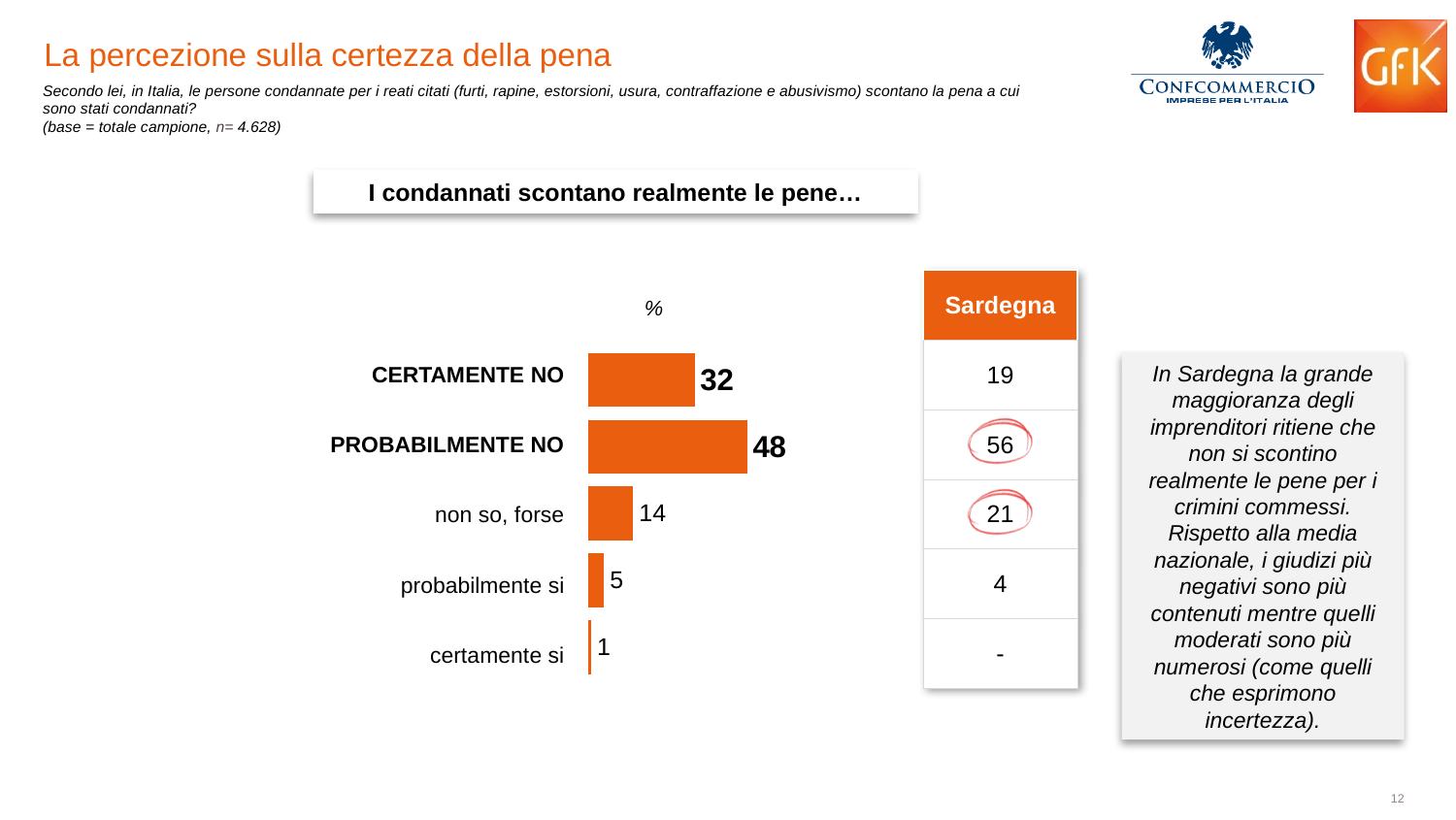
What value is shown for "non so, forse"? 14 Which category has the highest value in the bar chart? PROBABILMENTE NO Which is larger, the value for "non so, forse" or the value for "probabilmente si"? non so, forse What value is shown for "certamente si"? 1 How many categories are shown in the bar chart? 5 Which category has the lowest value in the bar chart? certamente si What percentage of respondents answered "CERTAMENTE NO"? 32 What value is shown for "PROBABILMENTE NO"? 48 What value is shown for "probabilmente si"? 5 What is the difference between the values for "PROBABILMENTE NO" and "CERTAMENTE NO"? 16 What type of chart is shown on the slide? bar chart What is the combined value of "CERTAMENTE NO" and "PROBABILMENTE NO"? 80